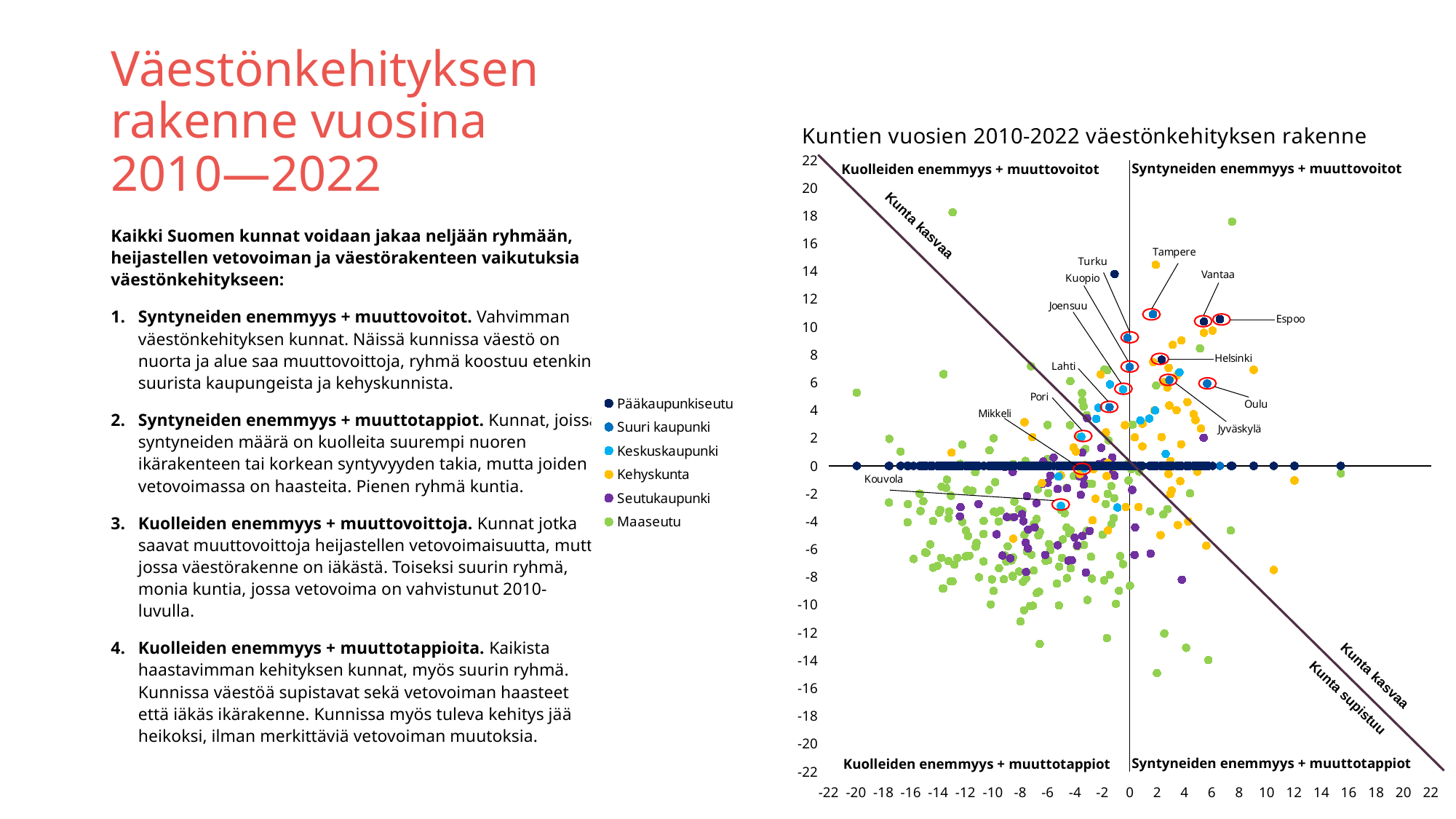
How many series does the chart legend list? 6 Among the labelled cities, which has the highest vertical-axis value? Turku Is the vertical-axis value for Espoo greater or less than 8? greater Which legend entry is shown in green? Maaseutu Is the horizontal-axis value for Kouvola greater or less than 0? less Is the vertical-axis value for Kouvola greater or less than 0? less What kind of chart is shown on the slide? Scatter chart Which has the higher vertical-axis value, Turku or Espoo? Turku What is the title of the chart? Kuntien vuosien 2010-2022 väestönkehityksen rakenne